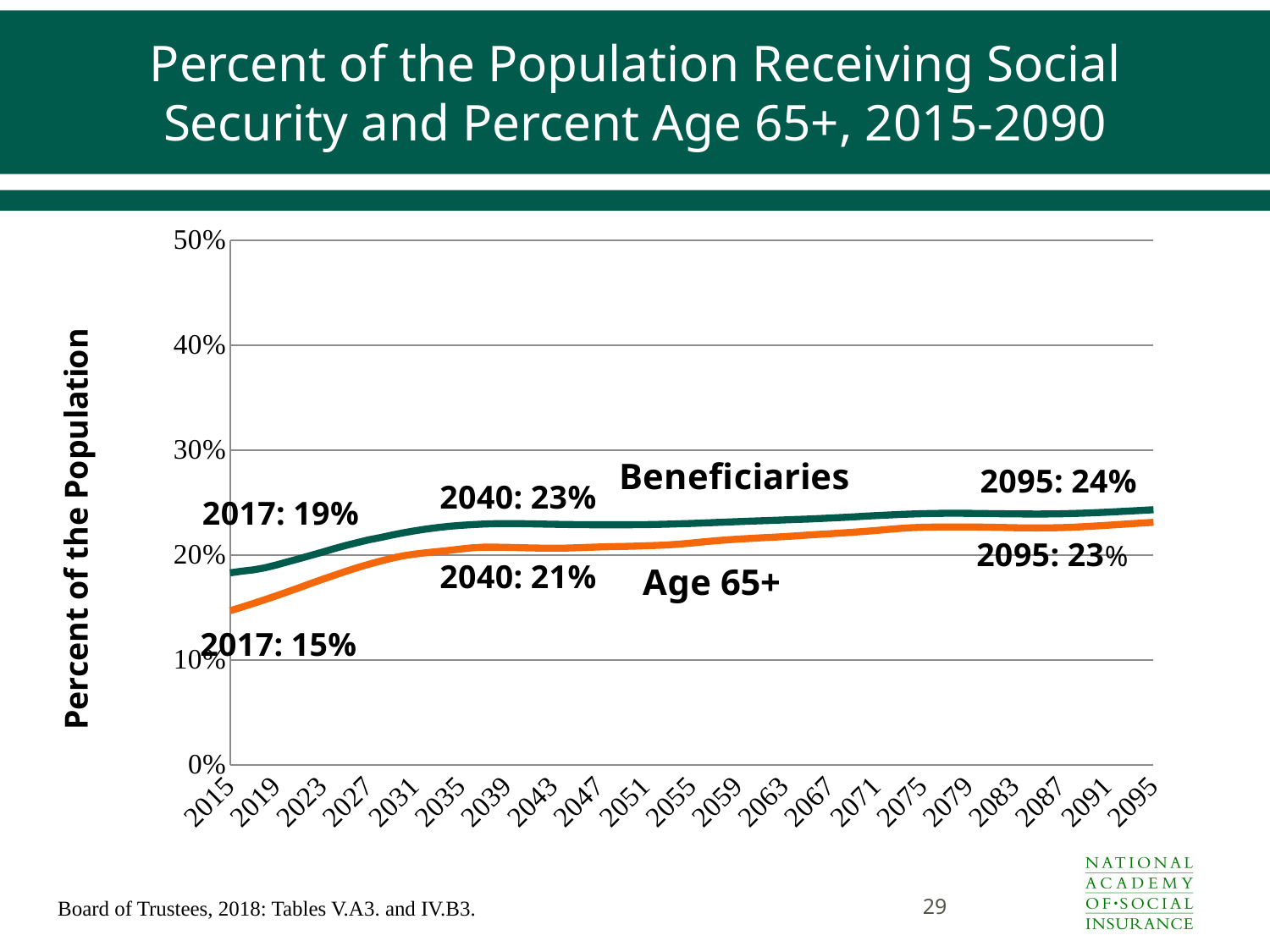
What is the Age 65+ value labelled for 2040? 21% What percent of the population were Beneficiaries in 2017? 19% What kind of chart is shown on the slide? line chart What is the Beneficiaries value labelled for 2040? 23% In 2017, how many percentage points higher is the Beneficiaries value than the Age 65+ value? 4 percentage points What is the Age 65+ value labelled for 2095? 23% Is the Age 65+ value in 2015 greater or less than 20%? less In 2095, which is larger: the Beneficiaries value or the Age 65+ value? Beneficiaries What percent of the population was Age 65+ in 2017? 15% Does the Beneficiaries line generally rise or fall from 2015 to 2095? rise In 2040, what is the difference between the Beneficiaries value and the Age 65+ value? 2 percentage points What is the Beneficiaries value labelled for 2095? 24%